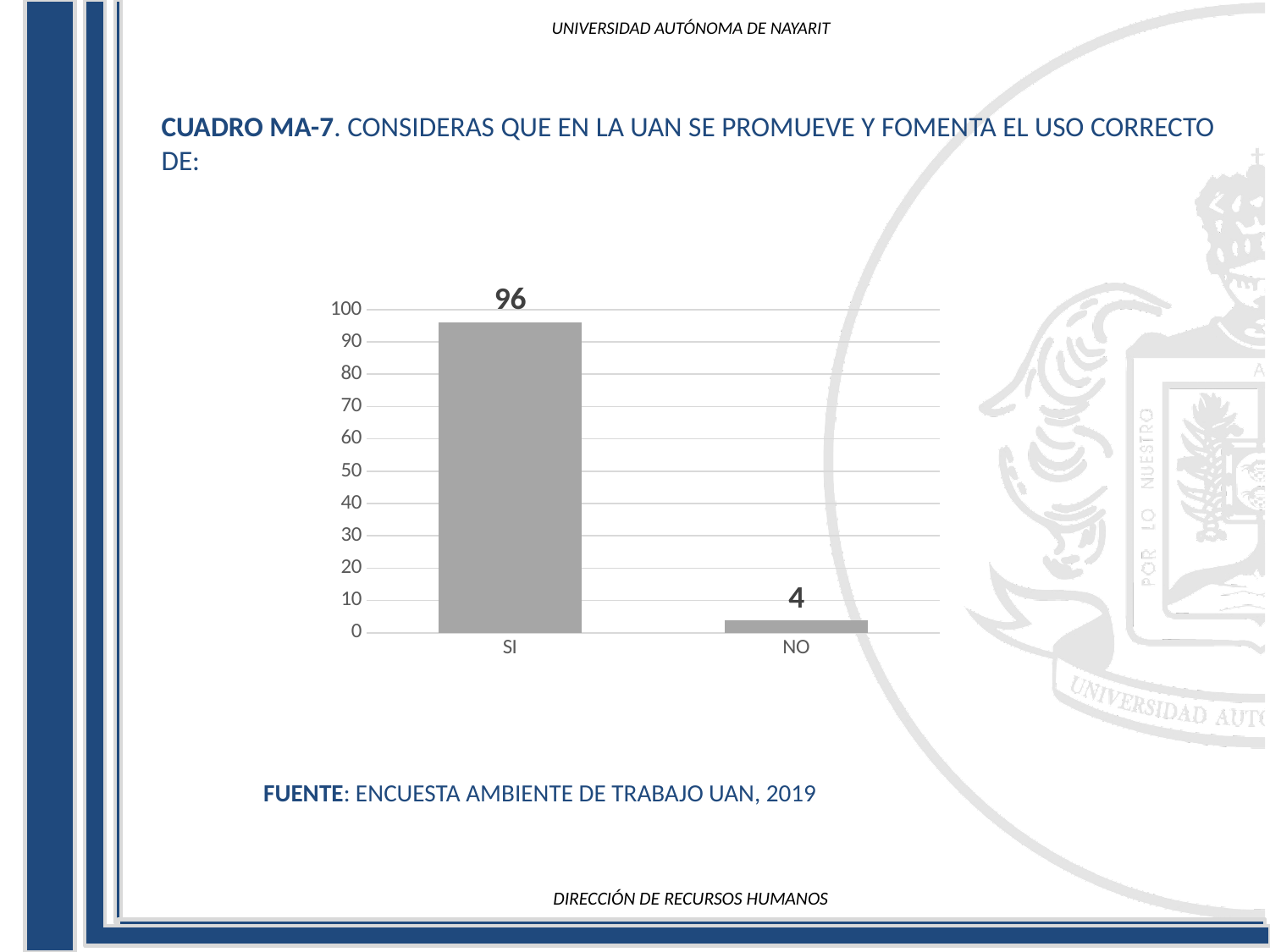
What is the difference between the values for SI and NO? 92 What is the value for NO? 4 What is the source cited below the chart? ENCUESTA AMBIENTE DE TRABAJO UAN, 2019 Is the value for NO greater or less than 10? less How many categories are shown on the x axis? 2 What is the total of the two values shown in the chart? 100 What is the value for SI? 96 Which is larger, the value for SI or the value for NO? SI Which category has the highest value? SI What kind of chart is shown on the slide? bar chart Which category has the lowest value? NO Is the value for SI greater or less than 90? greater